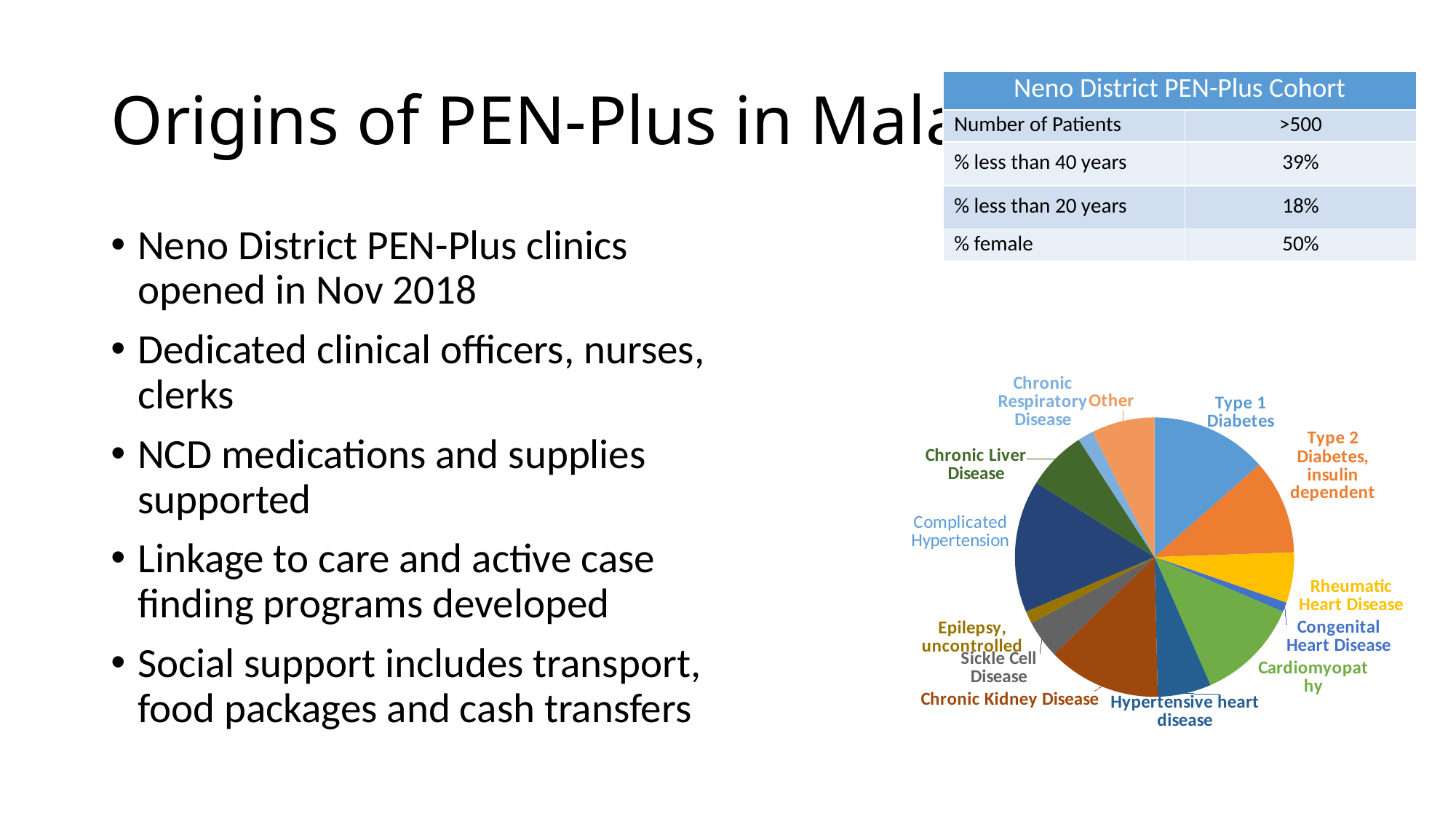
Which is larger in the pie chart, the slice for Cardiomyopathy or the slice for Chronic Respiratory Disease? Cardiomyopathy Which is larger in the pie chart, the slice for Type 1 Diabetes or the slice for Congenital Heart Disease? Type 1 Diabetes Which is larger in the pie chart, the slice for Complicated Hypertension or the slice for Epilepsy, uncontrolled? Complicated Hypertension What colour is the Type 1 Diabetes slice in the pie chart? Light blue How many categories (slices) does the pie chart show? 13 What kind of chart is shown on the slide? Pie chart What colour is the Rheumatic Heart Disease slice in the pie chart? Yellow